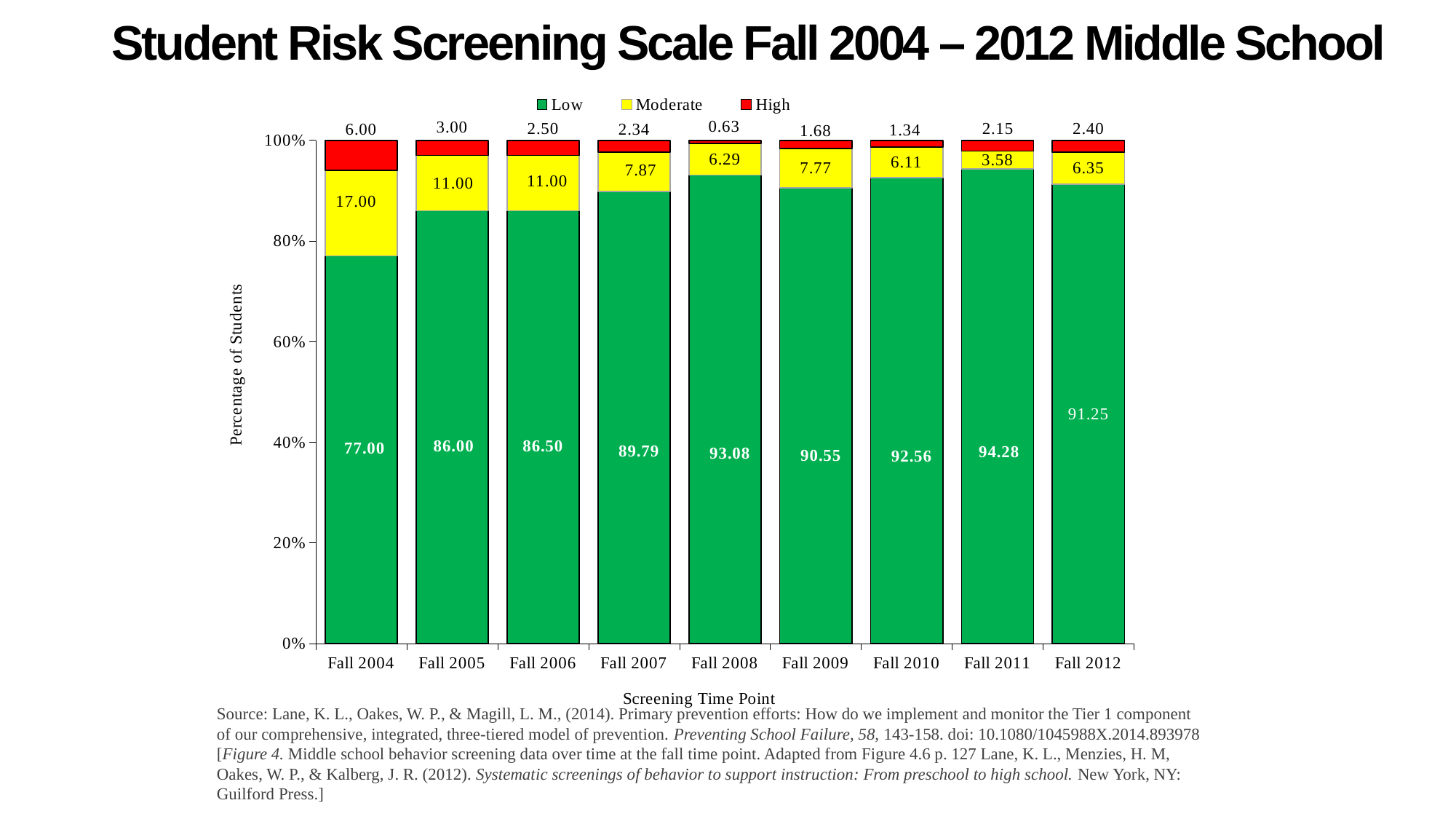
Which colour represents the High series in the legend? Red What is the Moderate value for Fall 2009? 7.77 What is the Low value for Fall 2004? 77.00 Which screening time point has the lowest Low value? Fall 2004 What is the High value for Fall 2008? 0.63 What is the difference between the Low values for Fall 2005 and Fall 2004? 9.00 Which screening time point has the highest Low value? Fall 2011 How many series does the legend list? 3 Which is larger, the Moderate value for Fall 2007 or for Fall 2010? Fall 2007 What kind of chart is shown on the slide? Stacked bar chart Which screening time point has the highest High value? Fall 2004 How many screening time points are shown on the x axis? 9